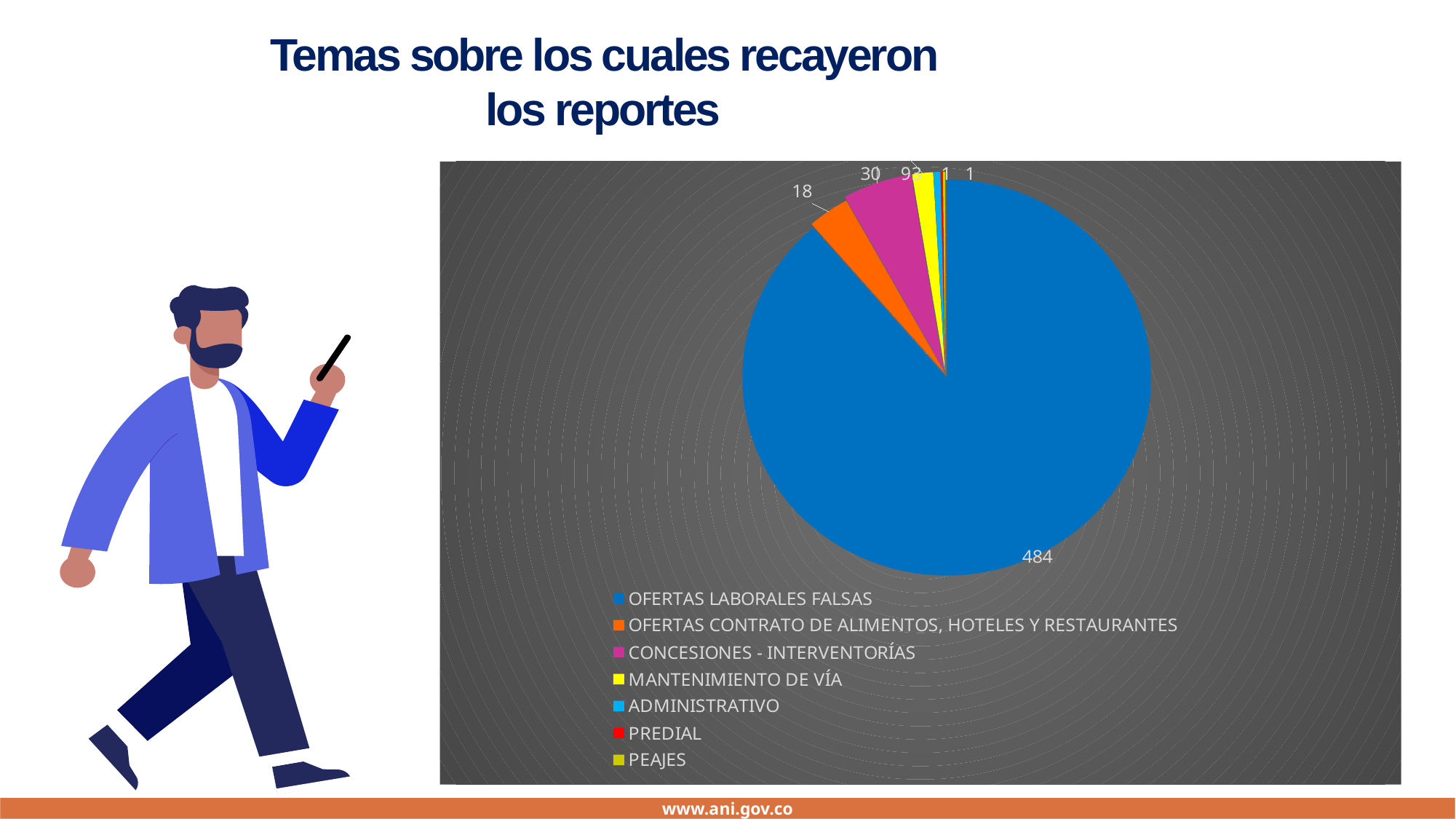
Which is larger: CONCESIONES - INTERVENTORÍAS or OFERTAS CONTRATO DE ALIMENTOS, HOTELES Y RESTAURANTES? CONCESIONES - INTERVENTORÍAS What kind of chart is shown on the slide? pie chart What is the difference between the values for OFERTAS LABORALES FALSAS and CONCESIONES - INTERVENTORÍAS? 454 What is the title of the slide above the chart? Temas sobre los cuales recayeron los reportes What is the value for CONCESIONES - INTERVENTORÍAS? 30 What colour is the slice for OFERTAS LABORALES FALSAS? blue What is the difference between the values for CONCESIONES - INTERVENTORÍAS and OFERTAS CONTRATO DE ALIMENTOS, HOTELES Y RESTAURANTES? 12 How many categories does the legend of the pie chart list? 7 What is the value for OFERTAS LABORALES FALSAS? 484 Which category has the largest slice of the pie? OFERTAS LABORALES FALSAS What is the value for PREDIAL? 1 What is the value for OFERTAS CONTRATO DE ALIMENTOS, HOTELES Y RESTAURANTES? 18